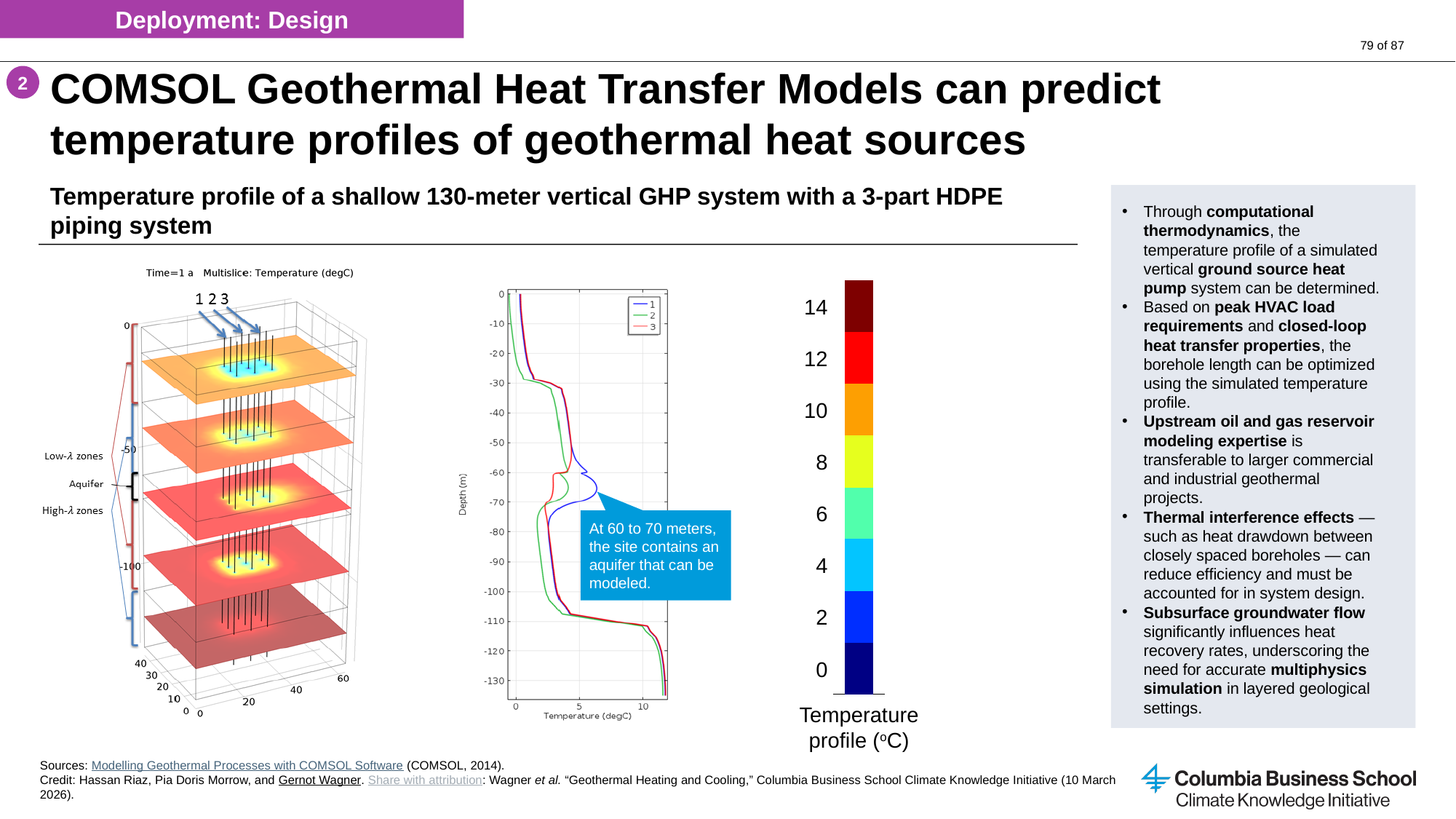
In the depth-versus-temperature line chart, at a depth of 0 m, is the temperature greater or less than 5 degC? less What is the highest value labelled on the temperature profile colour bar? 14 What kind of chart is the middle plot of Depth (m) against Temperature (degC)? line chart What is the title printed beneath the colour bar on the right of the charts? Temperature profile (°C) In the depth-versus-temperature line chart, at a depth of about -65 m, which series shows the higher temperature, series 1 or series 3? series 1 How many numeric tick labels are shown on the temperature profile colour bar? 8 In the depth-versus-temperature line chart, at a depth of -130 m, is the temperature greater or less than 10 degC? greater In the depth-versus-temperature line chart, does the temperature increase or decrease as depth goes from -100 m to -130 m? increase What is the lowest value labelled on the temperature profile colour bar? 0 In the depth-versus-temperature line chart, which series is drawn in green? 2 How many series does the legend of the depth-versus-temperature line chart list? 3 How many horizontal temperature slices are shown in the 3D multislice plot on the left? 5